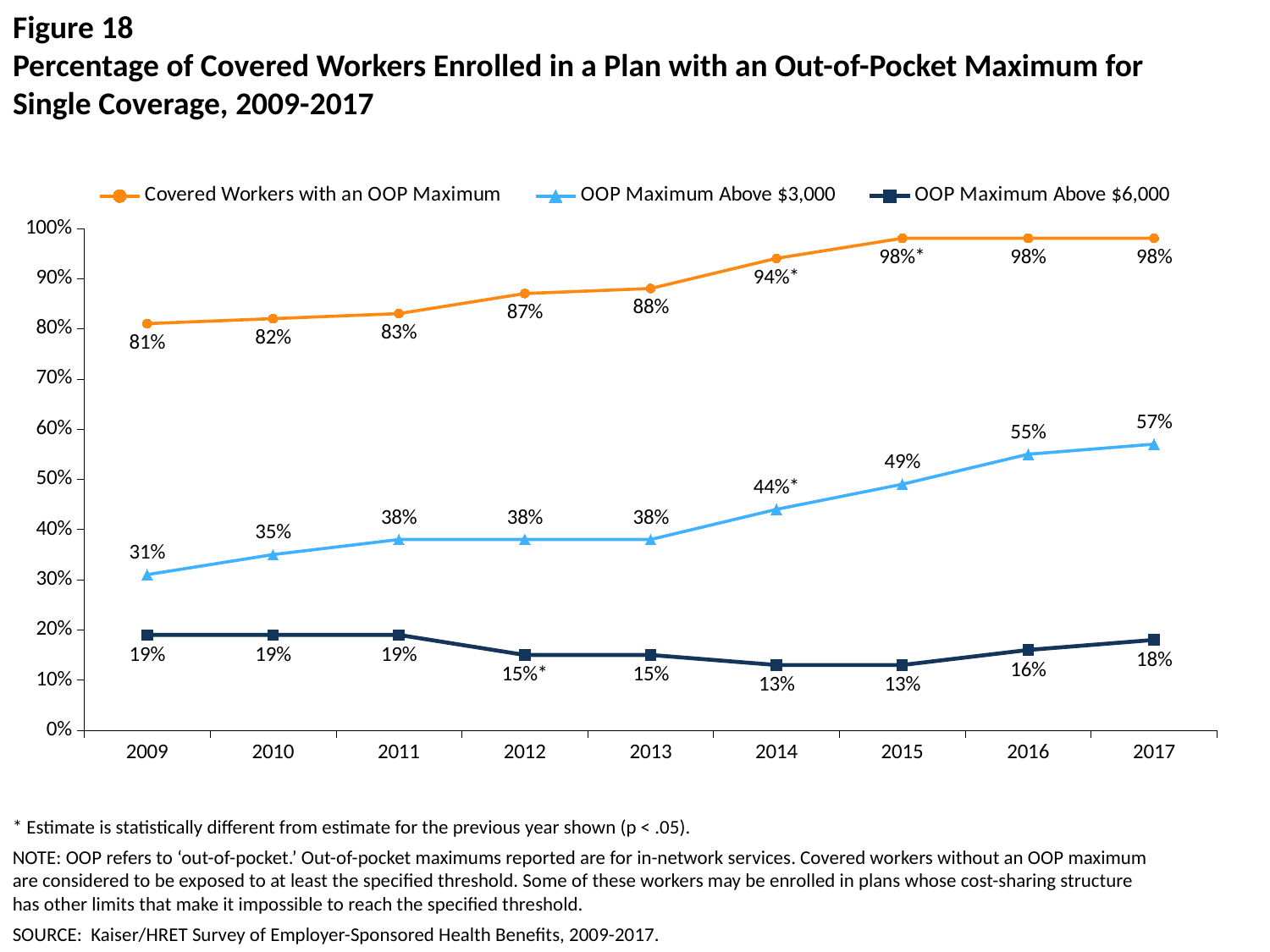
What percentage of covered workers had an OOP maximum in 2009? 81% What is the lowest value shown for the OOP Maximum Above $6,000 series? 13% How many years are shown on the x axis? 9 What was the value for OOP Maximum Above $6,000 in 2017? 18% How many series does the legend list? 3 What kind of chart is shown on the slide? Line chart In which year was the OOP Maximum Above $3,000 series at its highest? 2017 Which was larger in 2012: OOP Maximum Above $3,000 or OOP Maximum Above $6,000? OOP Maximum Above $3,000 Which series is shown with triangle markers? OOP Maximum Above $3,000 Does the Covered Workers with an OOP Maximum series generally rise or fall from 2009 to 2017? Rise What was the value for OOP Maximum Above $3,000 in 2014? 44% What is the difference between the OOP Maximum Above $3,000 values in 2017 and 2009? 26 percentage points